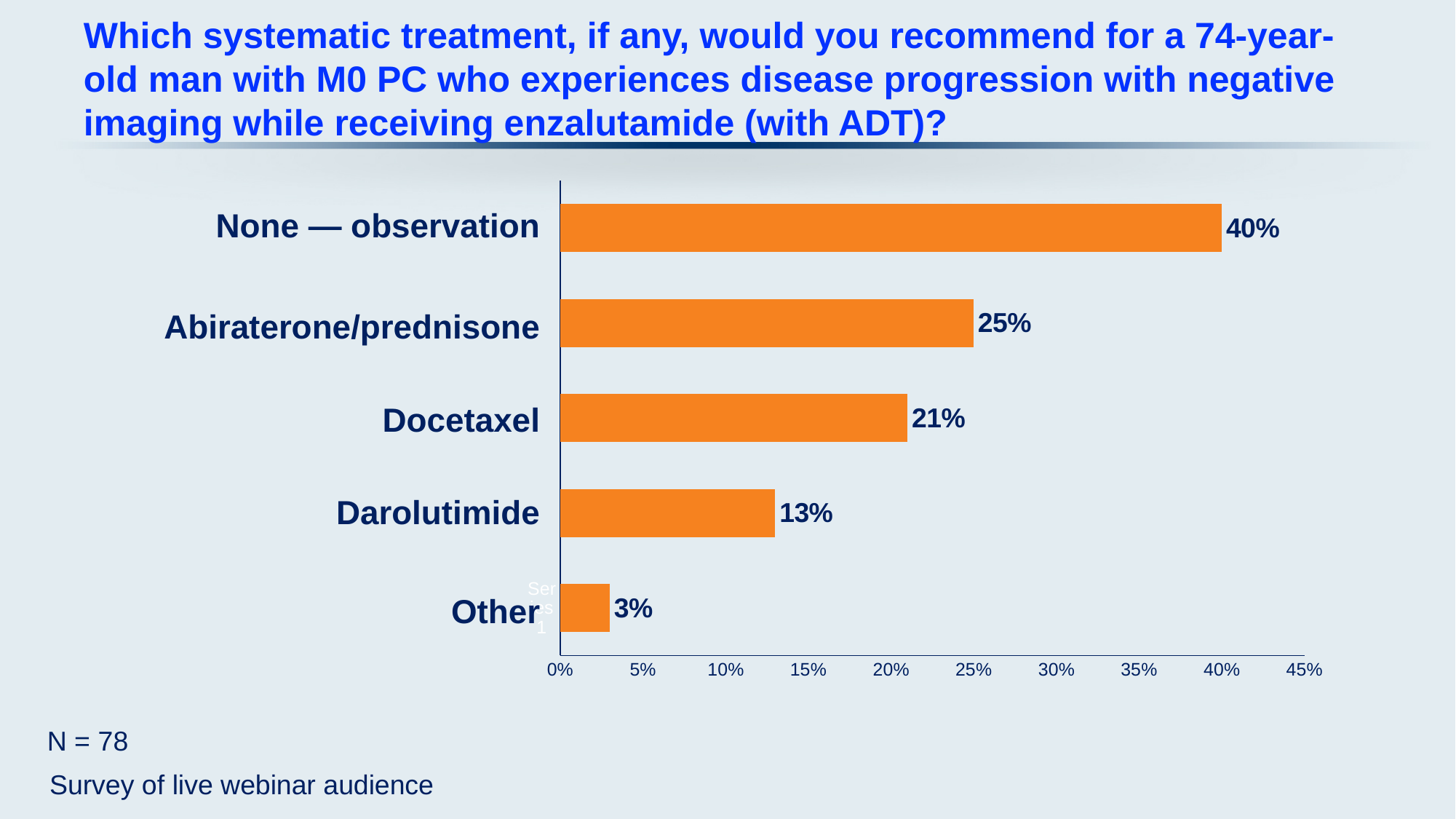
What type of chart is shown on the slide? Bar chart Which treatment option received the highest percentage of responses? None — observation What percentage of respondents chose Darolutimide? 13% What percentage of respondents chose Docetaxel? 21% What percentage of respondents chose Other? 3% What percentage of respondents chose Abiraterone/prednisone? 25% What percentage of respondents chose None — observation? 40% How many treatment options are shown on the chart? 5 Which received a larger share of responses, Docetaxel or Darolutimide? Docetaxel What is the difference in percentage points between None — observation and Abiraterone/prednisone? 15 What is the sample size (N) stated on the slide? 78 Which option received the lowest percentage of responses? Other